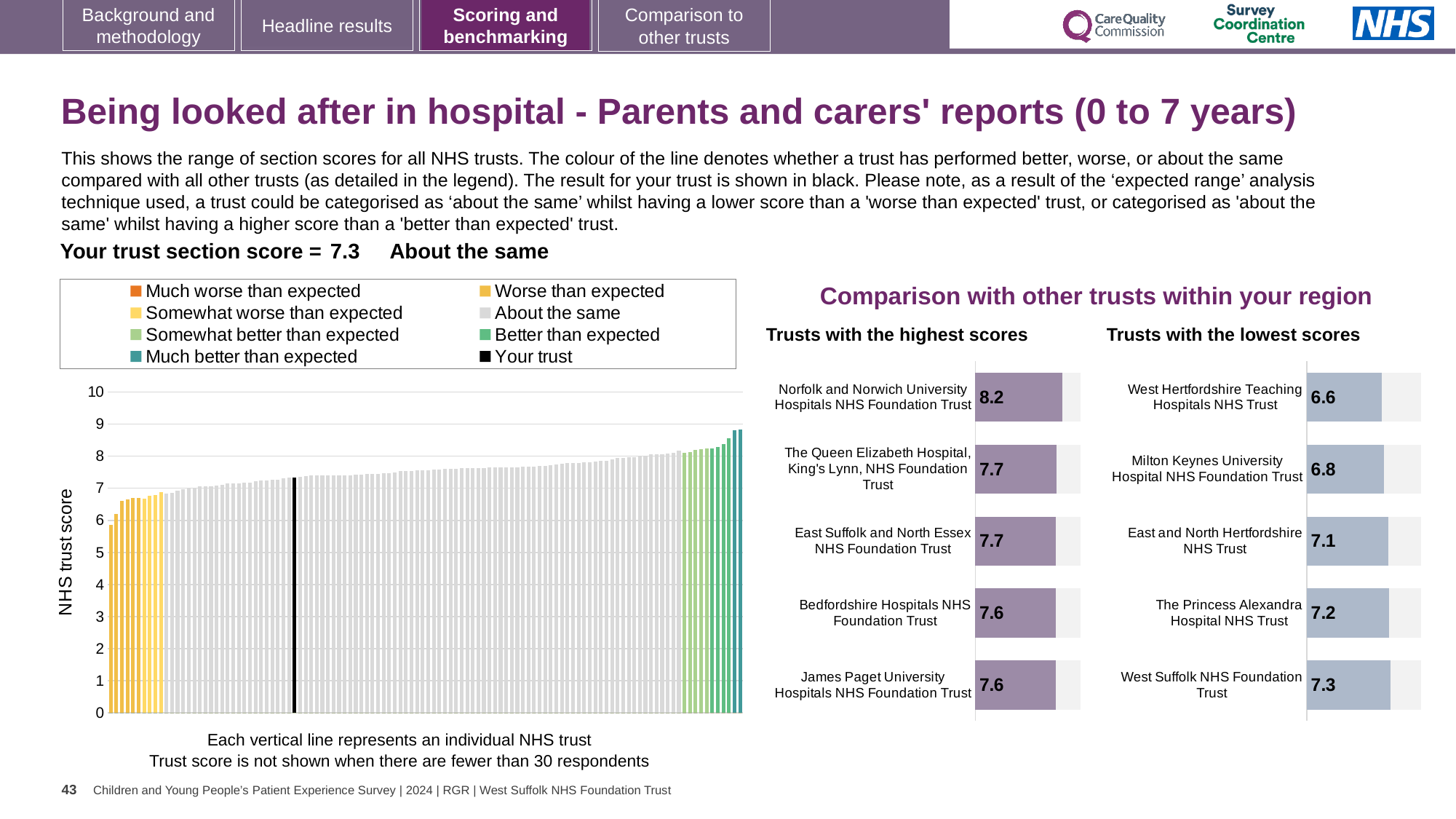
In the main chart on the left, is the value of the tallest bar greater or less than 8? greater In the main chart on the left, is the value for the black 'Your trust' bar greater or less than 7? greater In the 'Trusts with the lowest scores' chart, what is the score for Milton Keynes University Hospital NHS Foundation Trust? 6.8 How many trusts are listed in the 'Trusts with the highest scores' chart? 5 In the 'Trusts with the highest scores' chart, which trust has the highest score? Norfolk and Norwich University Hospitals NHS Foundation Trust In the 'Trusts with the lowest scores' chart, which has the higher score: Milton Keynes University Hospital NHS Foundation Trust or The Princess Alexandra Hospital NHS Trust? The Princess Alexandra Hospital NHS Trust In the 'Trusts with the highest scores' chart, what is the score for Norfolk and Norwich University Hospitals NHS Foundation Trust? 8.2 What kind of chart is the main chart on the left of the slide? bar chart In the 'Trusts with the highest scores' chart, what is the difference between the scores of Norfolk and Norwich University Hospitals NHS Foundation Trust and James Paget University Hospitals NHS Foundation Trust? 0.6 How many entries does the legend of the main chart on the left list? 8 In the 'Trusts with the lowest scores' chart, what is the difference between the scores of West Suffolk NHS Foundation Trust and West Hertfordshire Teaching Hospitals NHS Trust? 0.7 In the 'Trusts with the lowest scores' chart, which trust has the lowest score? West Hertfordshire Teaching Hospitals NHS Trust